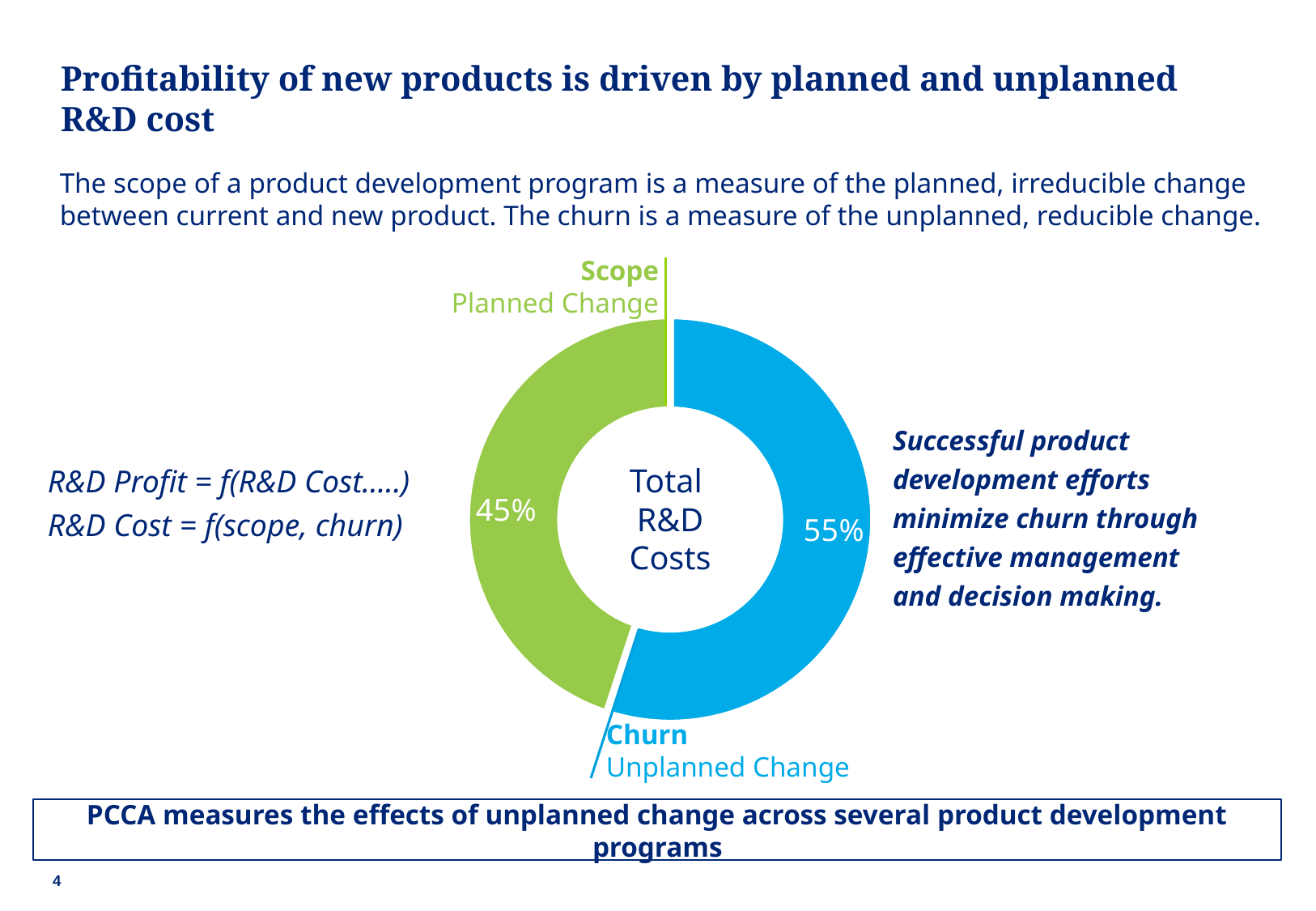
How many slices does the chart have? 2 Which is larger, the Scope slice or the Churn slice? Churn What do the two slices of the chart add up to? 100% Which slice of the chart is the largest? Churn (Unplanned Change) What colour is the Churn (Unplanned Change) slice? Blue What is the difference in percentage points between the Churn and Scope slices? 10 percentage points What share of Total R&D Costs is Scope (Planned Change)? 45% What kind of chart is shown on the slide? Doughnut (pie) chart Is the share for Scope (Planned Change) greater or less than 50%? less What text is shown in the centre of the doughnut chart? Total R&D Costs What share of Total R&D Costs is Churn (Unplanned Change)? 55% Which slice of the chart is the smallest? Scope (Planned Change)